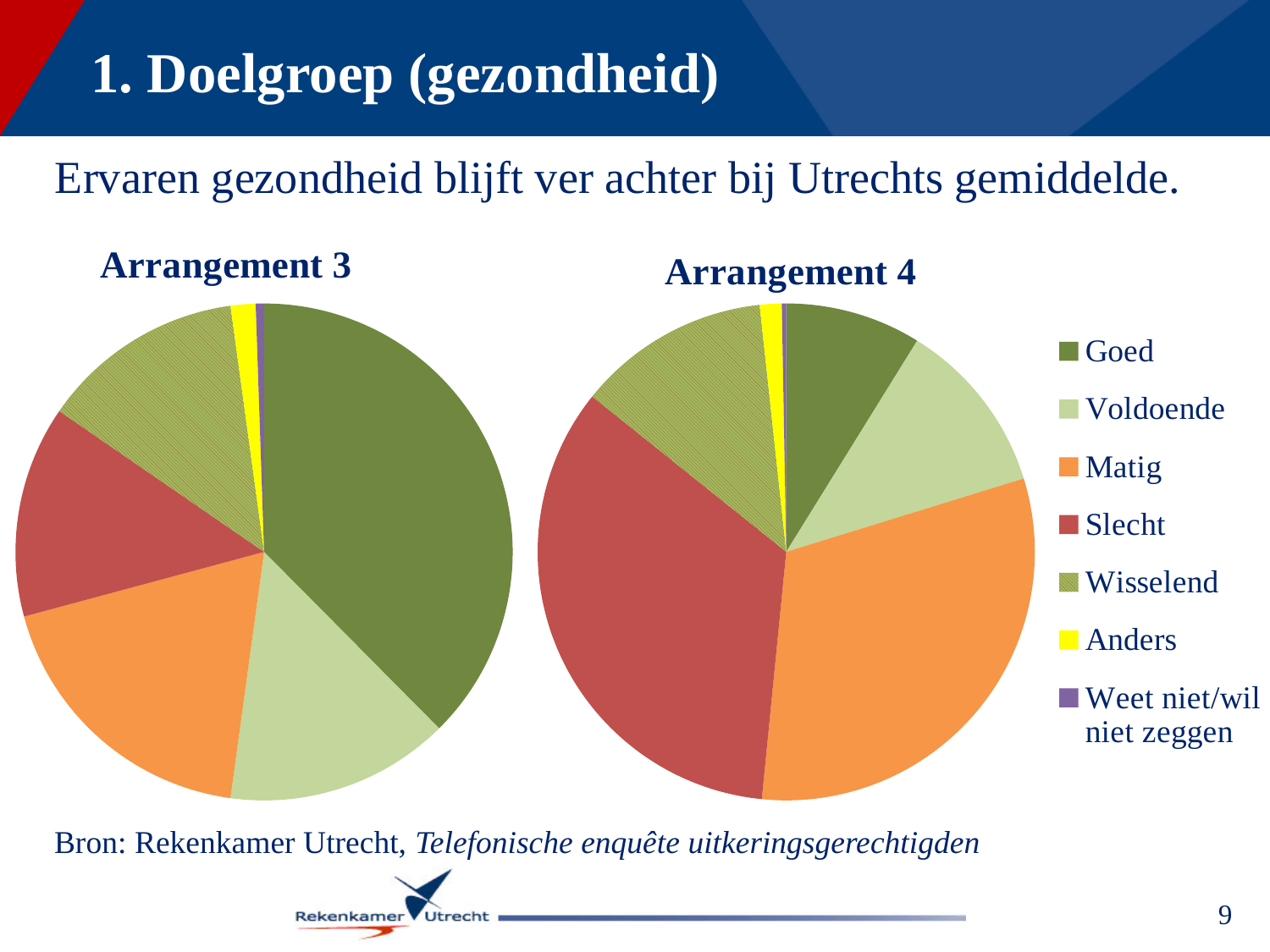
In the Arrangement 4 pie chart, which slice is larger: Matig or Voldoende? Matig What is the title of the pie chart on the right? Arrangement 4 What kind of chart is used for Arrangement 3? Pie chart In the Arrangement 3 pie chart, which category has the smallest slice? Weet niet/wil niet zeggen In the Arrangement 3 pie chart, which slice is larger: Goed or Matig? Goed How many pie charts are shown on the slide? 2 In the Arrangement 4 pie chart, which slice is larger: Slecht or Goed? Slecht In the Arrangement 3 pie chart, which category has the largest slice? Goed In the Arrangement 4 pie chart, which category has the smallest slice? Weet niet/wil niet zeggen How many categories does the legend list? 7 Which category is shown in yellow in the legend? Anders